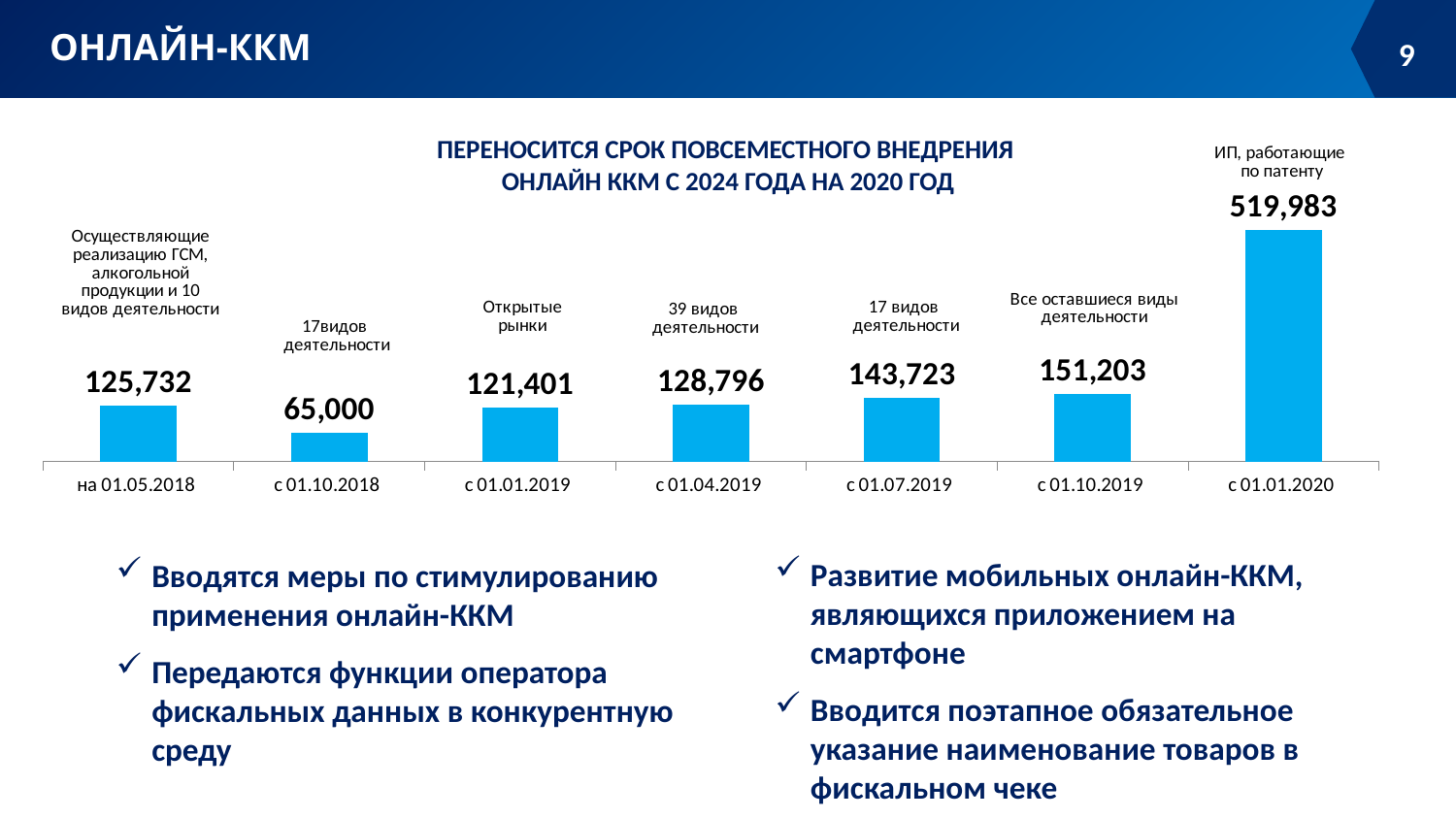
What is the difference between the values for на 01.05.2018 and с 01.10.2018? 60,732 What kind of chart is shown on the slide? Bar chart What value is shown for the bar labelled с 01.07.2019? 143,723 Which is larger, the value for с 01.04.2019 or the value for с 01.01.2019? с 01.04.2019 Which category has the highest value in the chart? с 01.01.2020 How many bars are shown in the chart? 7 Which category has the lowest value in the chart? с 01.10.2018 What value is shown for the bar labelled с 01.10.2018? 65,000 What is the difference between the values for с 01.10.2019 and с 01.07.2019? 7,480 What value is shown for the bar labelled на 01.05.2018? 125,732 What value is shown for the bar labelled с 01.01.2020? 519,983 Which group is described above the bar for с 01.01.2020? ИП, работающие по патенту